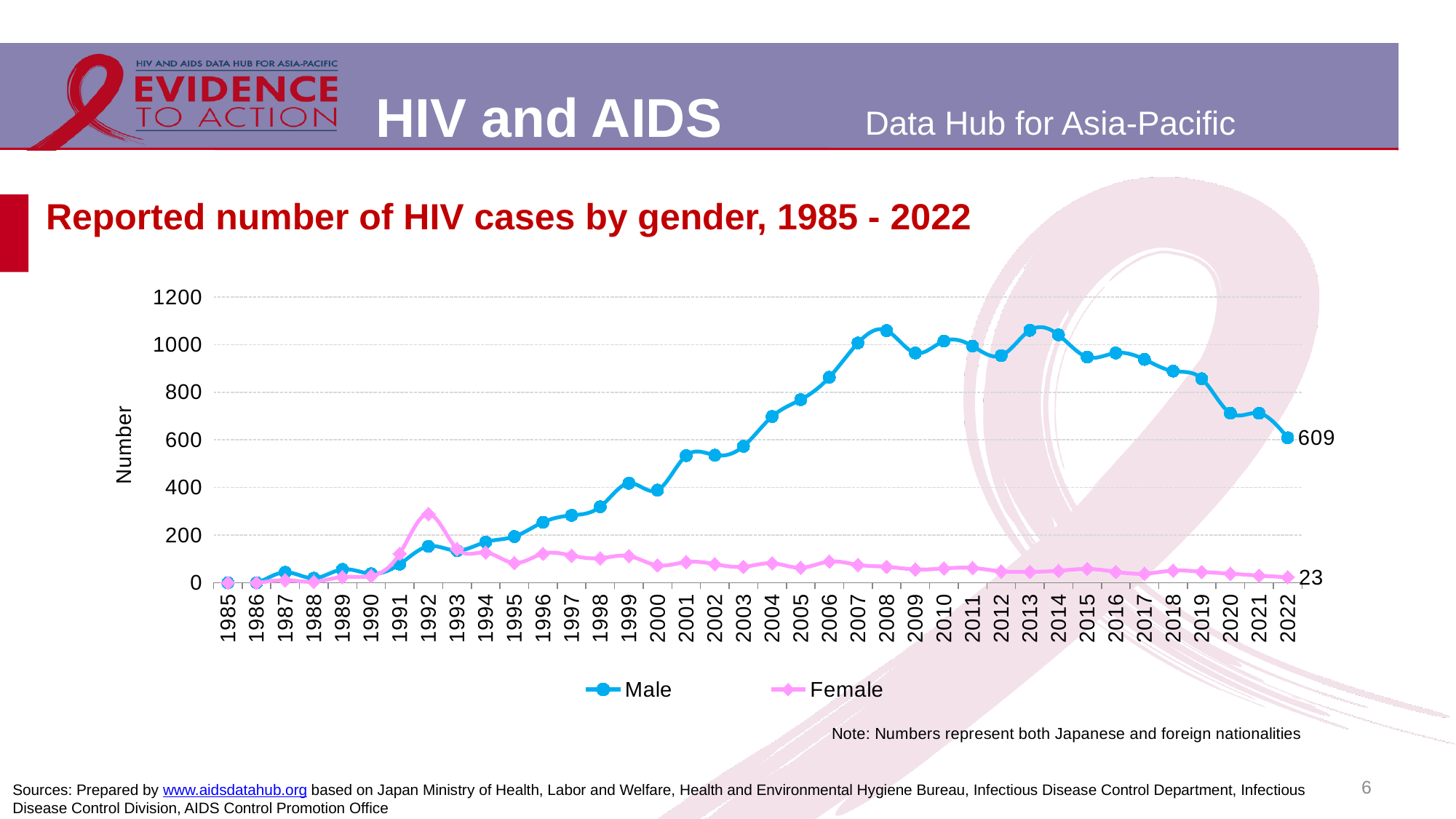
What is the difference between the male and female reported HIV cases in 2022? 586 How many series does the legend list? 2 What is the title of the chart? Reported number of HIV cases by gender, 1985 - 2022 What kind of chart is shown on the slide? Line chart Is the value for Female in 1992 greater or less than 200? greater In 1992, which series has the larger value, Male or Female? Female What is the reported number of female HIV cases in 2022? 23 Do the Male values rise or fall from 2013 to 2022? fall How many years are plotted along the x axis? 38 What is the reported number of male HIV cases in 2022? 609 In 2022, which series has the larger value, Male or Female? Male Is the value for Male in 2008 greater or less than 1000? greater